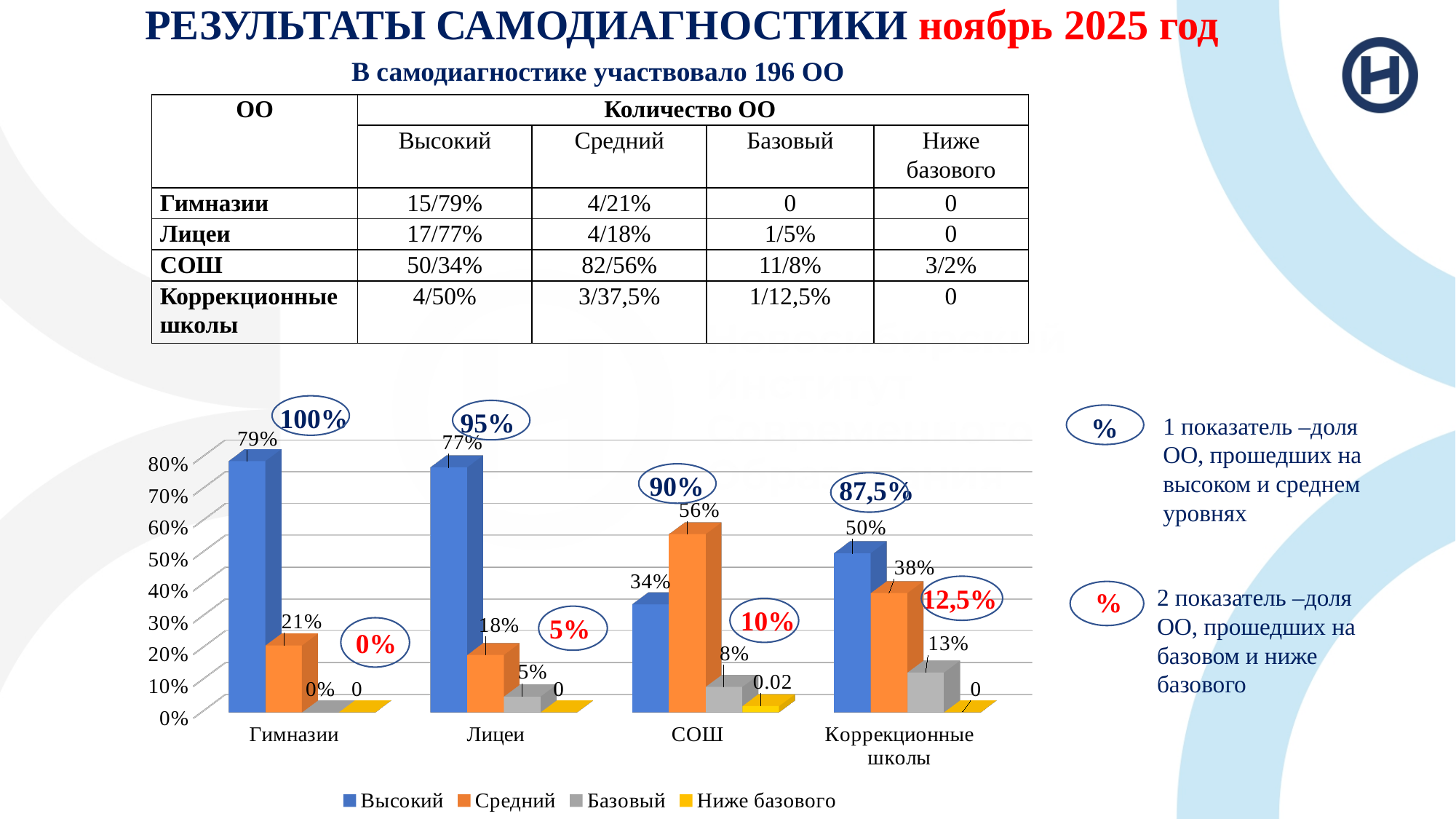
Which series is shown in orange in the chart legend? Средний What type of chart is shown on the slide? bar chart What is the value of the Высокий series for Гимназии? 79% Which category has the highest value in the Высокий series? Гимназии For СОШ, which is larger: the Высокий value or the Средний value? Средний What is the value of the Ниже базового series for СОШ? 0.02 What is the value of the Базовый series for Коррекционные школы? 13% Which category has the lowest value in the Высокий series? СОШ What is the value of the Средний series for СОШ? 56% How many series does the chart legend list? 4 How many categories are shown on the x axis of the chart? 4 What is the difference between the Высокий and Средний values for Лицеи? 59%